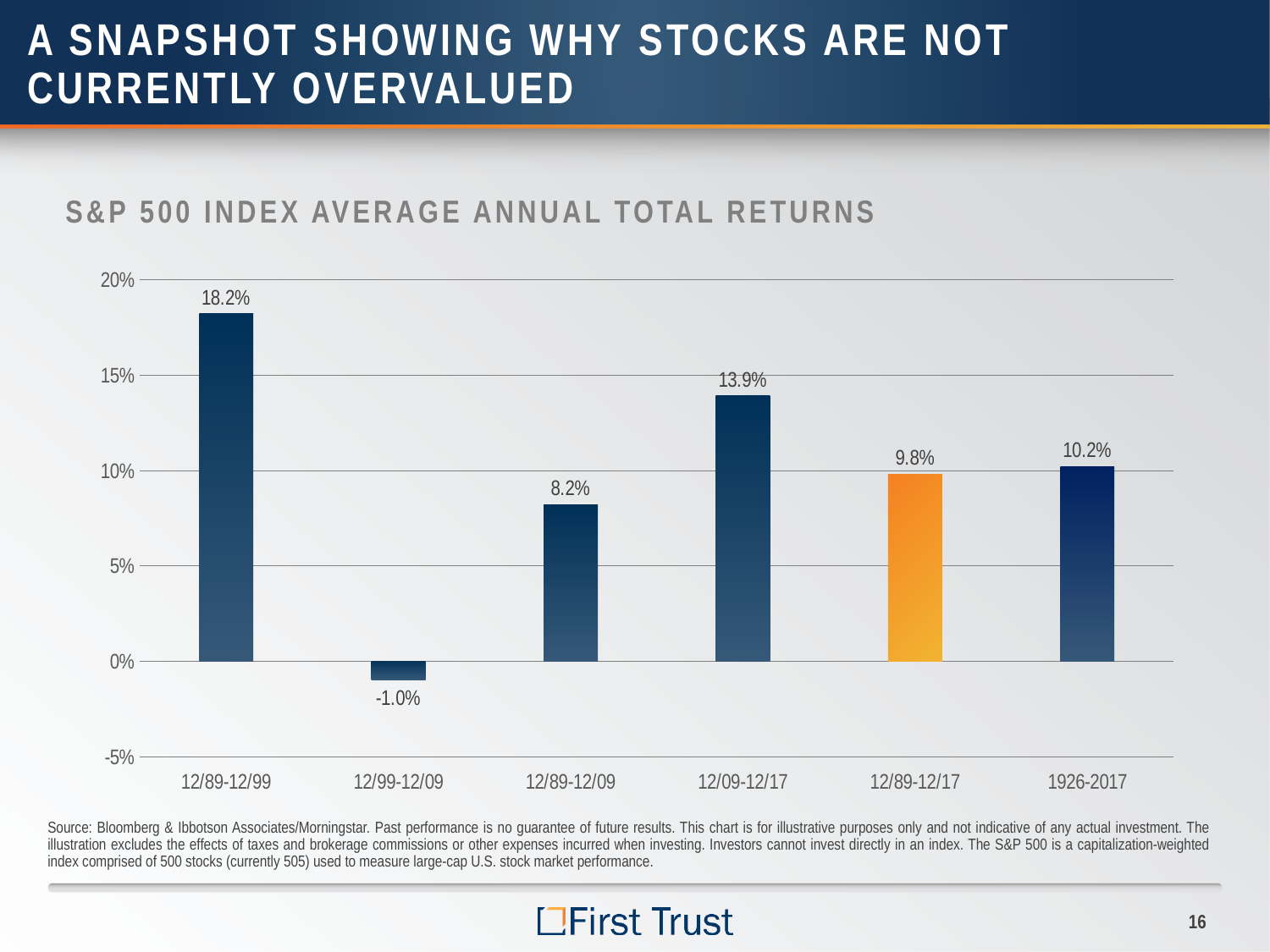
What is the average annual total return for 12/99-12/09? -1.0% What kind of chart is shown on the slide? Bar chart Which period's bar is coloured orange instead of blue? 12/89-12/17 Which period has the lowest average annual total return? 12/99-12/09 What is the value shown for 12/89-12/17? 9.8% Is the value for 12/89-12/17 greater or less than 10%? less What is the average annual total return for 12/89-12/99? 18.2% What is the average annual total return for 1926-2017? 10.2% What is the difference between the returns for 12/89-12/99 and 12/09-12/17? 4.3% Which period has the highest average annual total return? 12/89-12/99 How many periods are shown on the chart? 6 Which is larger, the return for 12/89-12/09 or the return for 12/09-12/17? 12/09-12/17